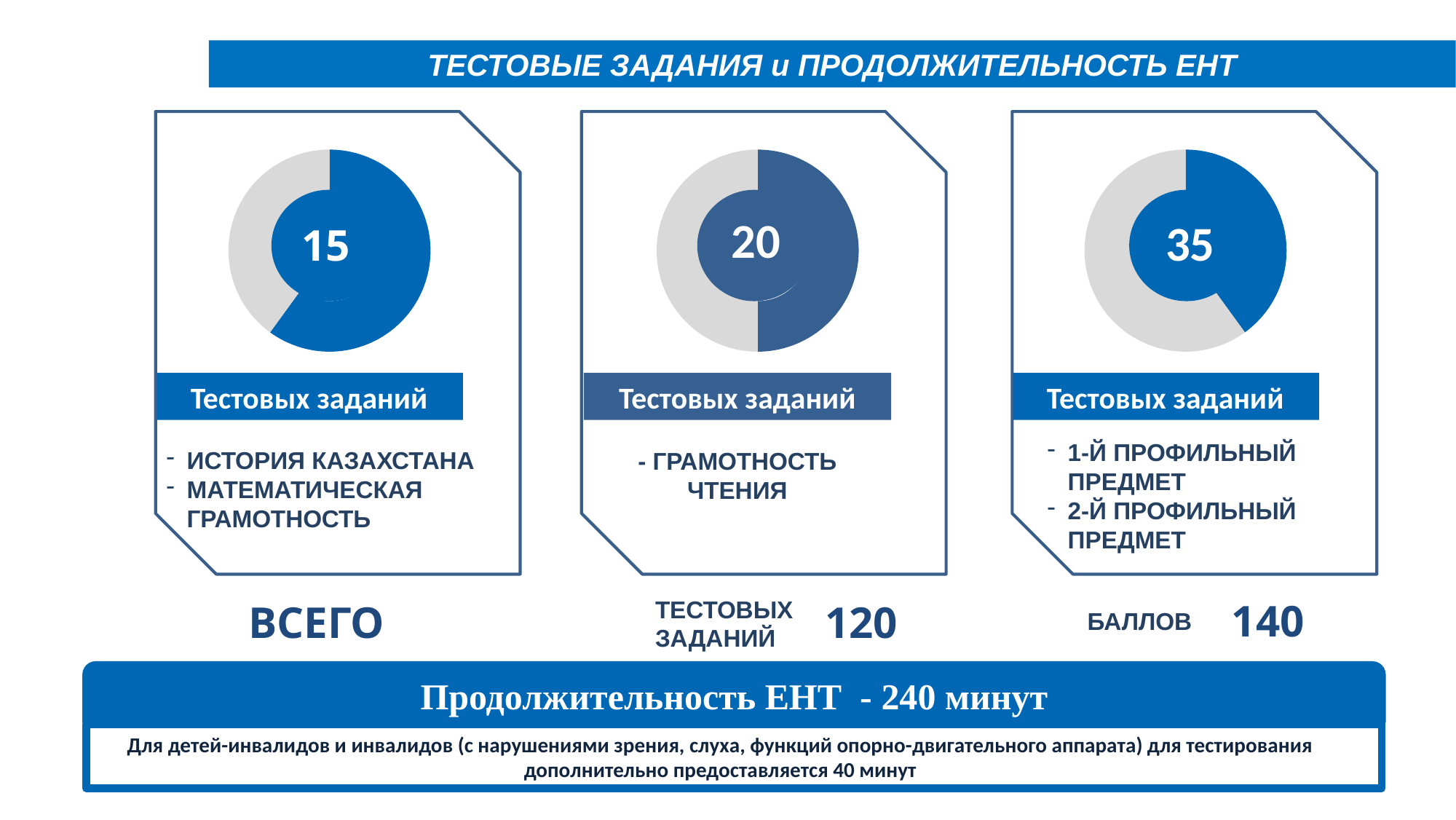
Which of the three donut charts shows the lowest value? The left chart (15) What value is shown in the centre of the right donut chart? 35 What label appears directly below each of the three donut charts? Тестовых заданий What is the difference between the value in the right donut chart and the value in the left donut chart? 20 Which is larger: the value in the middle donut chart or the value in the left donut chart? The middle chart (20) What is the difference between the value in the right donut chart and the value in the middle donut chart? 15 Which of the three donut charts shows the highest value? The right chart (35) What kind of chart is used in each of the three panels on the slide? Donut chart Which subject is listed under the middle donut chart (value 20)? Грамотность чтения How many donut charts are shown on the slide? 3 What value is shown in the centre of the middle donut chart? 20 What value is shown in the centre of the left donut chart? 15